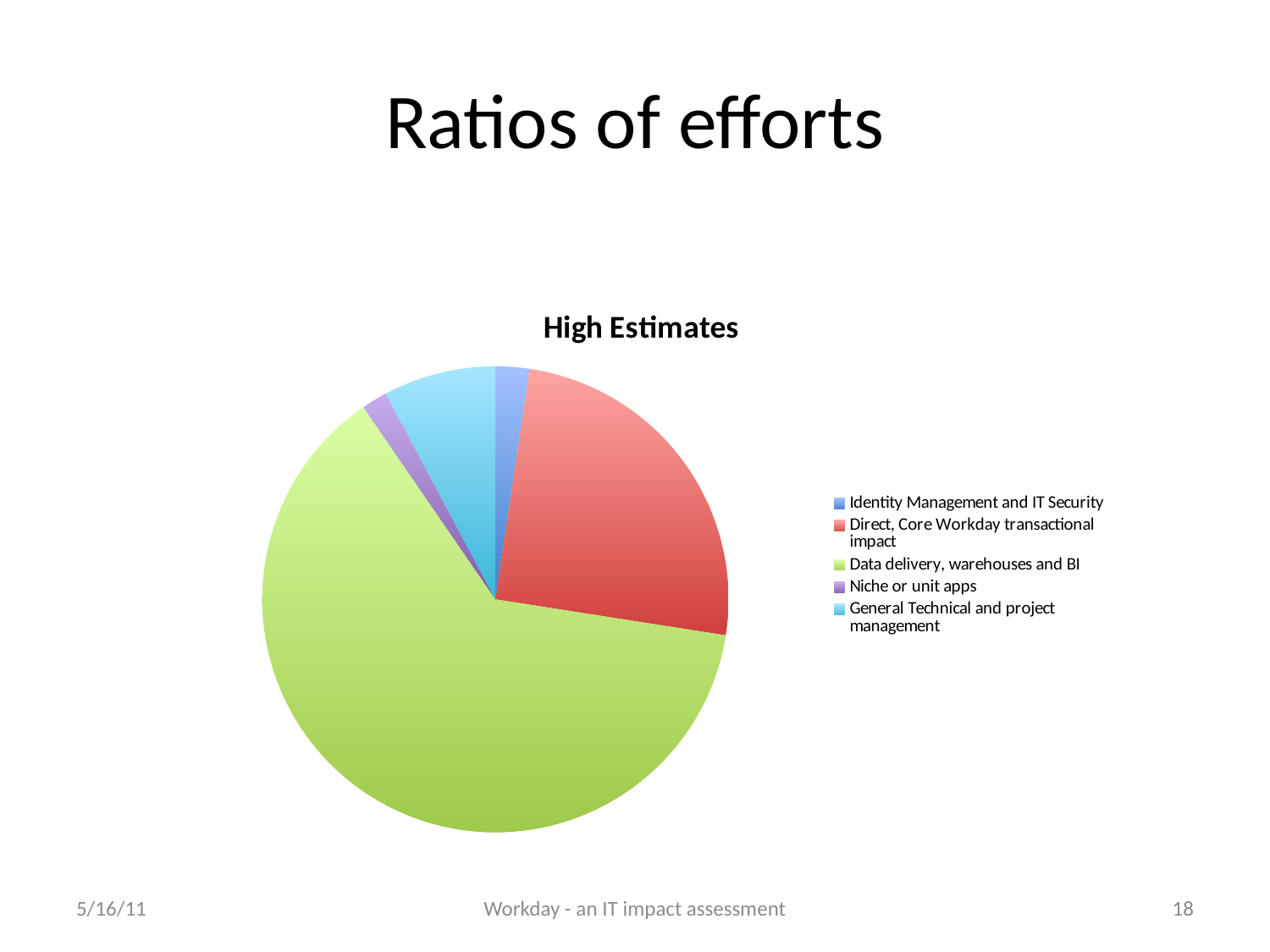
How many entries does the legend list? 5 What is the title of the chart? High Estimates Which slice is larger: General Technical and project management or Identity Management and IT Security? General Technical and project management What kind of chart is shown on the slide? pie chart Which slice is larger: Direct, Core Workday transactional impact or General Technical and project management? Direct, Core Workday transactional impact How many slices does the pie chart have? 5 Which category is shown in green in the pie chart? Data delivery, warehouses and BI Which category has the largest slice of the pie? Data delivery, warehouses and BI Which slice is larger: Data delivery, warehouses and BI or Direct, Core Workday transactional impact? Data delivery, warehouses and BI Which category has the smallest slice of the pie? Niche or unit apps